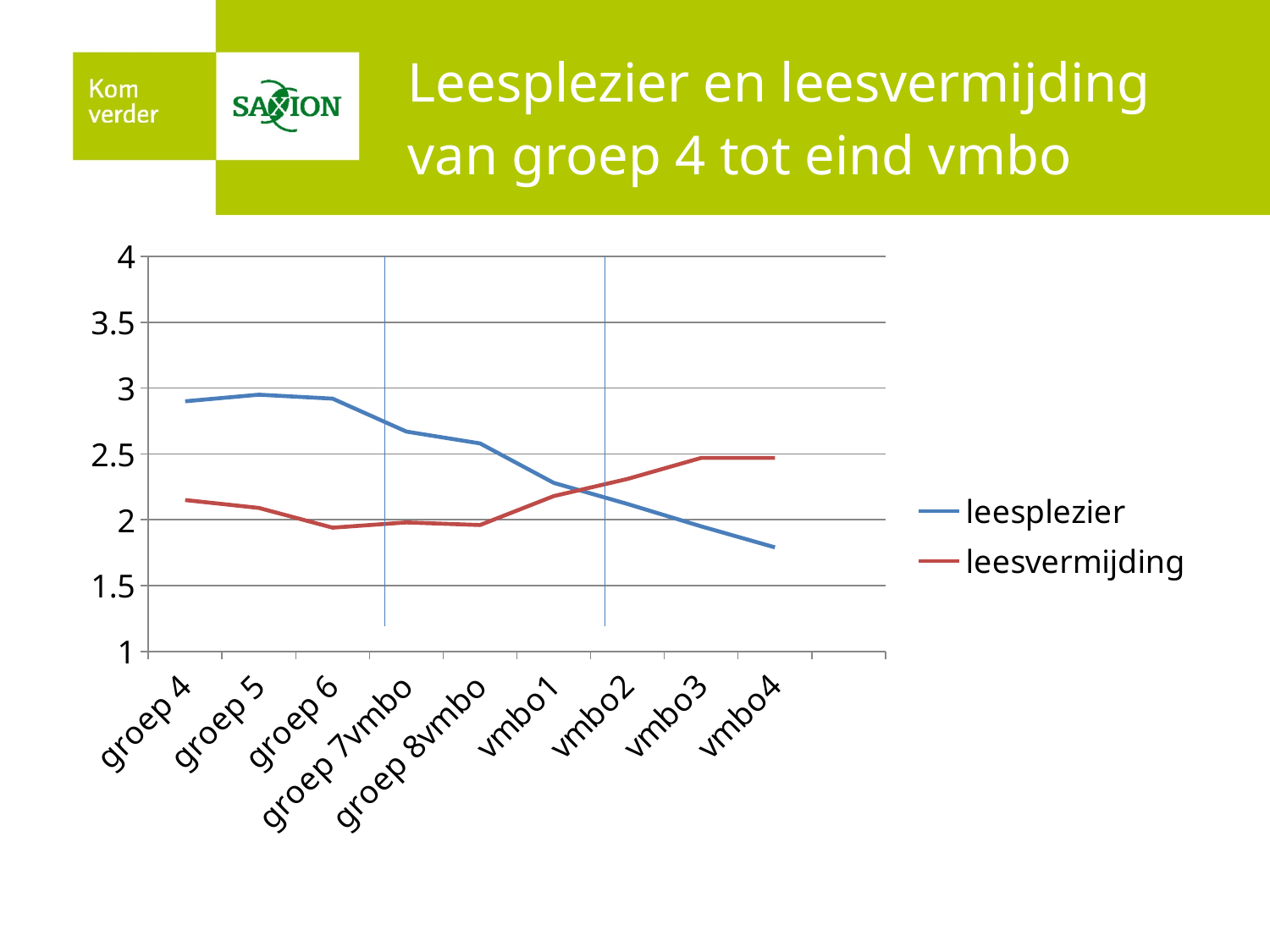
Which series is drawn in blue? leesplezier Is the value for leesplezier at vmbo4 greater or less than 2? less How many categories are shown on the x axis? 9 Does the leesplezier line rise or fall from groep 4 to vmbo4? fall Is the value for leesvermijding at groep 4 greater or less than 2? greater How many series does the legend list? 2 At groep 4, which is larger: leesplezier or leesvermijding? leesplezier Is the value for leesplezier at groep 4 greater or less than 2.5? greater At which category is leesplezier lowest? vmbo4 Does the leesvermijding line rise or fall overall from groep 4 to vmbo4? rise What kind of chart is shown on the slide? line chart At vmbo4, which is larger: leesplezier or leesvermijding? leesvermijding